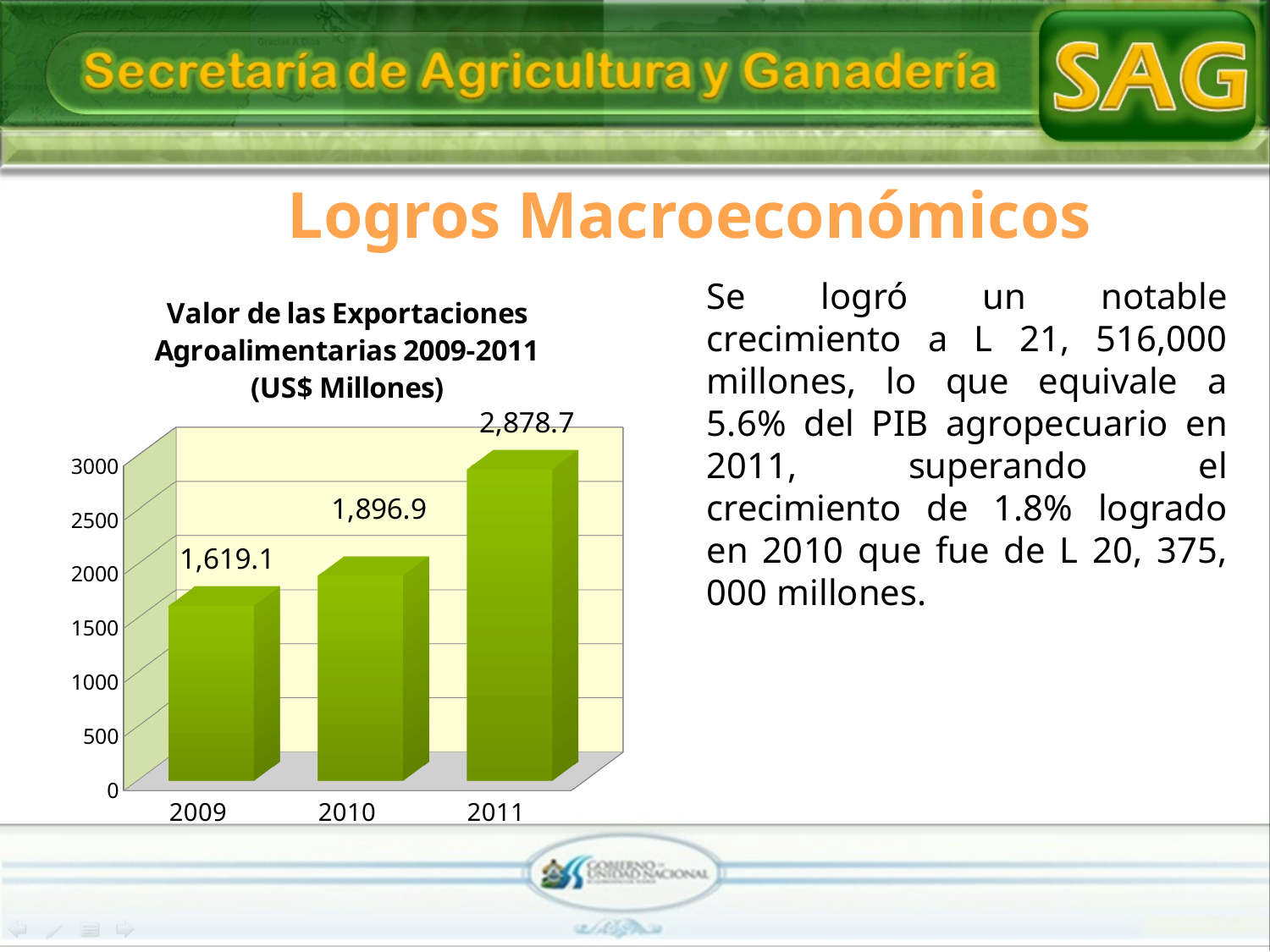
What is the value of agri-food exports for 2009? 1,619.1 What is the value of agri-food exports for 2010? 1,896.9 Do the export values rise or fall from 2009 to 2011? rise Which year has the highest export value? 2011 What is the value of agri-food exports for 2011? 2,878.7 What is the difference between the export values for 2011 and 2010? 981.8 Which year has the lowest export value? 2009 Is the value for 2011 greater or less than 2500? greater What kind of chart is shown on the slide? bar chart Which year has a larger export value, 2009 or 2010? 2010 What is the difference between the export values for 2010 and 2009? 277.8 How many years are shown on the chart? 3